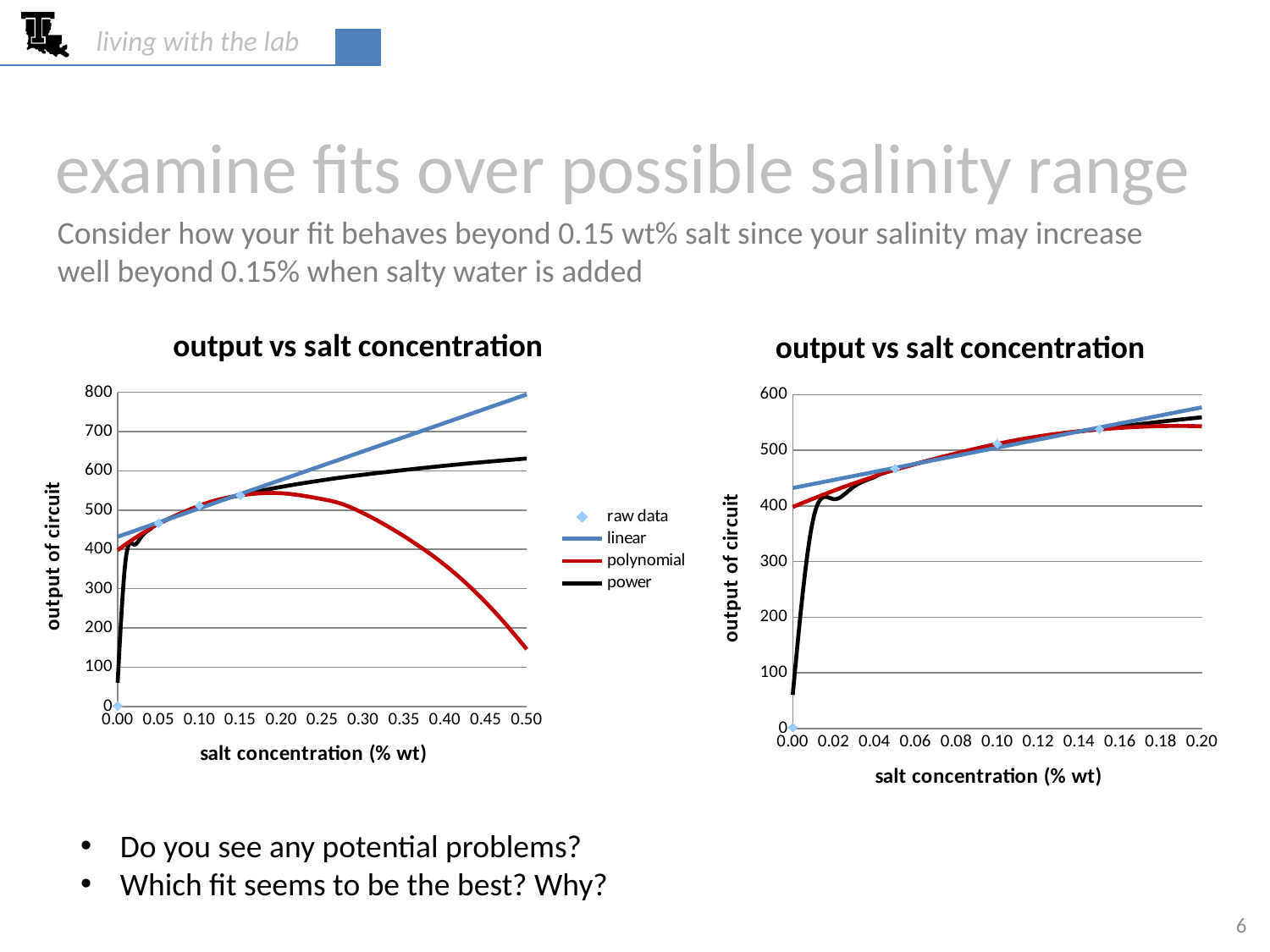
On the left chart, which fit has the highest value at a salt concentration of 0.50? linear How many series does the legend of the left chart list? 4 On the left chart, which fit has the lowest value at a salt concentration of 0.50? polynomial On the left chart, is the value of the linear fit at a salt concentration of 0.50 greater or less than 700? greater What is the label of the y axis on the right chart? output of circuit On the left chart, at a salt concentration of 0.50, which is larger: the power fit or the polynomial fit? power On the left chart, is the value of the polynomial fit at a salt concentration of 0.50 greater or less than 200? less On the left chart, does the polynomial fit rise or fall between salt concentrations of 0.30 and 0.50? fall What are the legend entries of the left chart? raw data, linear, polynomial, power On the left chart, is the value of the power fit at a salt concentration of 0.50 greater or less than 600? greater What kind of chart is the left chart titled "output vs salt concentration"? line chart